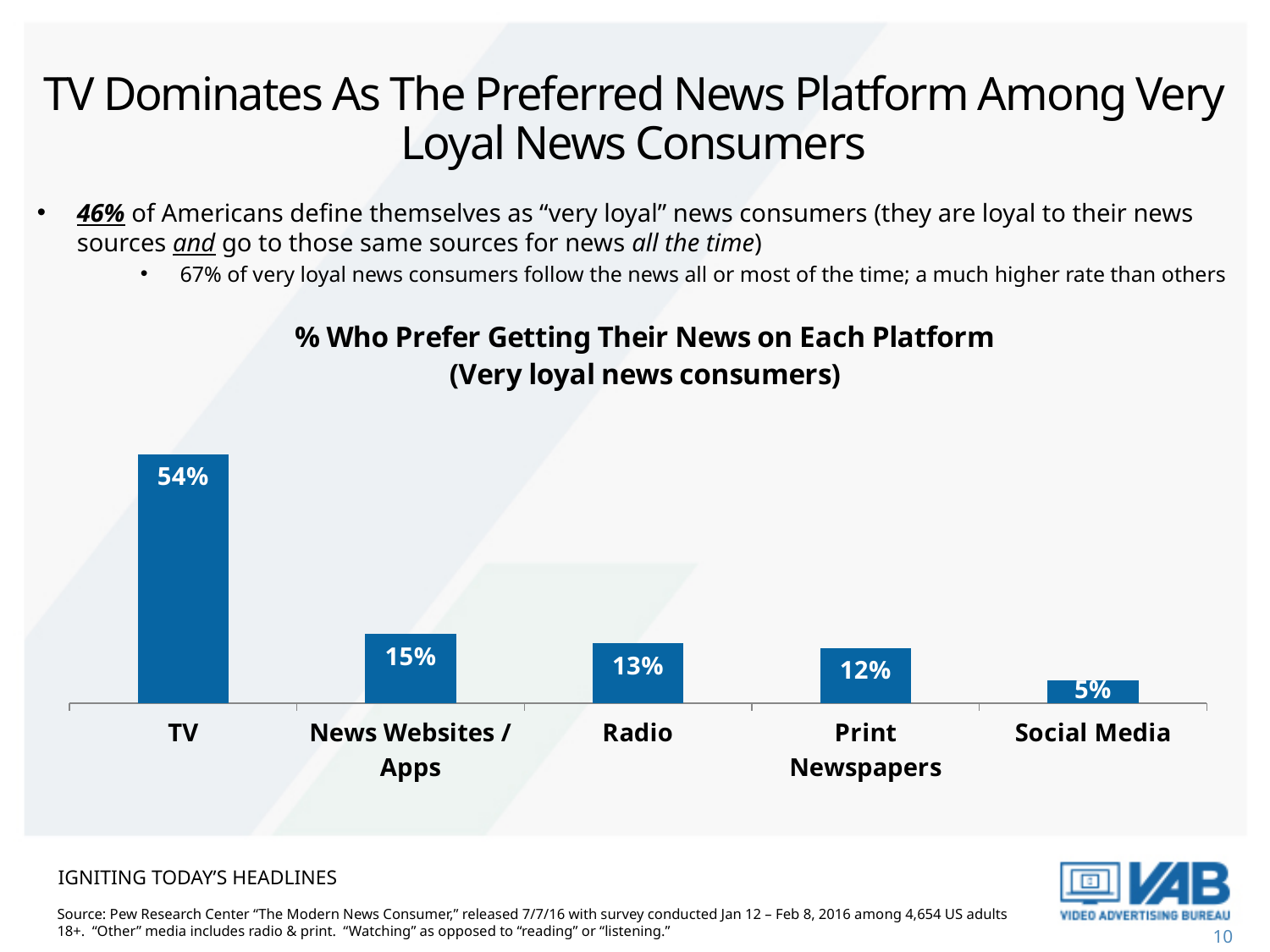
What is the value shown for Social Media? 5% Which is larger, the value for Radio or the value for Print Newspapers? Radio How many platforms are shown in the chart? 5 What is the value shown for Radio? 13% What is the difference in percentage points between TV and News Websites / Apps? 39 What type of chart is used on this slide? Bar chart What percentage of very loyal news consumers prefer getting their news on TV? 54% What is the value shown for Print Newspapers? 12% What is the difference in percentage points between Radio and Social Media? 8 Which platform has the lowest percentage in the chart? Social Media What is the value shown for News Websites / Apps? 15% Which platform has the highest percentage of very loyal news consumers preferring it? TV